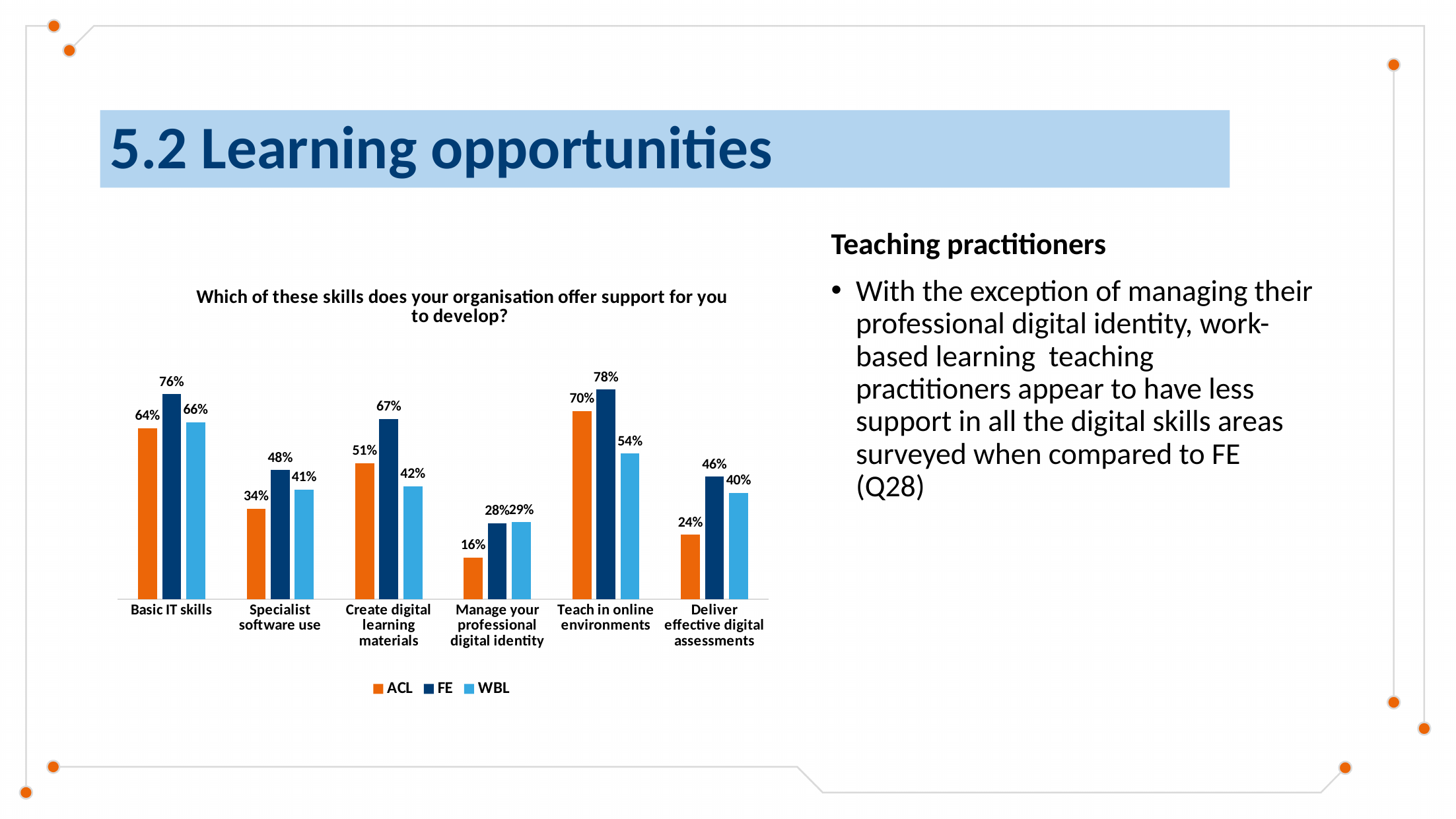
What is the difference between the FE and WBL values for Create digital learning materials? 25% Which category has the highest FE value? Teach in online environments What is the FE value for Basic IT skills? 76% Which is larger for Basic IT skills, the ACL value or the WBL value? WBL Which series is shown in orange in the legend? ACL What is the title of the chart? Which of these skills does your organisation offer support for you to develop? What kind of chart is shown on the slide? Bar chart How many series does the legend list? 3 How many categories are shown on the x axis? 6 What is the ACL value for Manage your professional digital identity? 16% Which category has the lowest ACL value? Manage your professional digital identity What is the WBL value for Teach in online environments? 54%